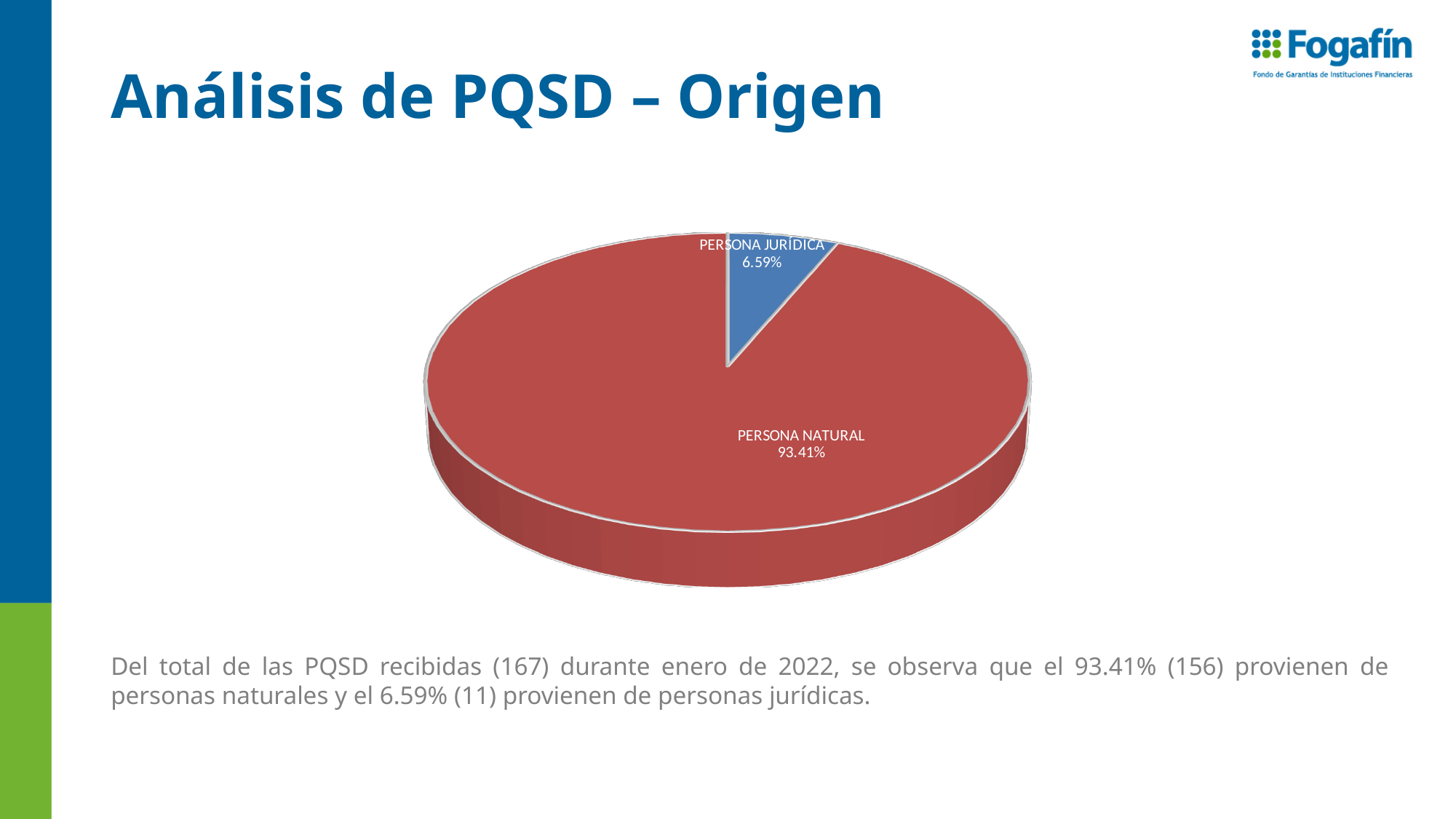
What kind of chart is shown on the slide? Pie chart What share of the pie does PERSONA NATURAL represent? 93.41% What is the difference in percentage points between the PERSONA NATURAL and PERSONA JURÍDICA slices? 86.82 What share of the pie does PERSONA JURÍDICA represent? 6.59% Which slice of the pie is the largest? PERSONA NATURAL What colour is the PERSONA JURÍDICA slice? Blue How many slices does the pie chart have? 2 Which is larger, the PERSONA JURÍDICA slice or the PERSONA NATURAL slice? PERSONA NATURAL Which slice of the pie is the smallest? PERSONA JURÍDICA What colour is the PERSONA NATURAL slice? Red